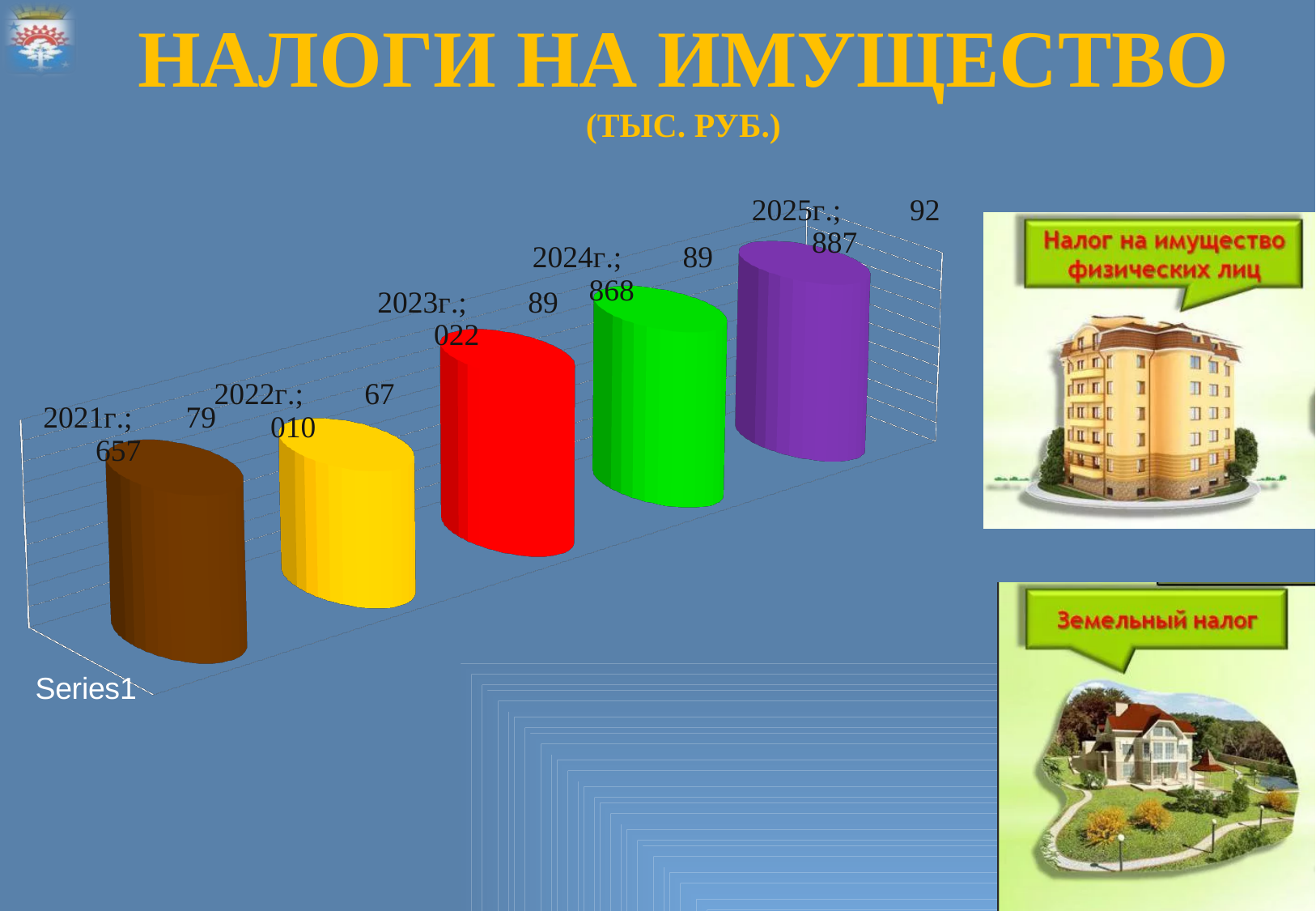
From 2022г. to 2025г., do the values rise or fall? rise What is the value for 2021г. on the chart? 79 657 What kind of chart is shown on the slide? bar chart What is the difference between the values for 2023г. and 2022г.? 22 012 What is the value for 2022г. on the chart? 67 010 Which year has the highest value on the chart? 2025г. Which is larger, the value for 2021г. or the value for 2022г.? 2021г. What is the value for 2025г. on the chart? 92 887 What is the difference between the values for 2025г. and 2024г.? 3 019 Which year has the lowest value on the chart? 2022г. How many years are shown on the chart? 5 What is the value for 2024г. on the chart? 89 868